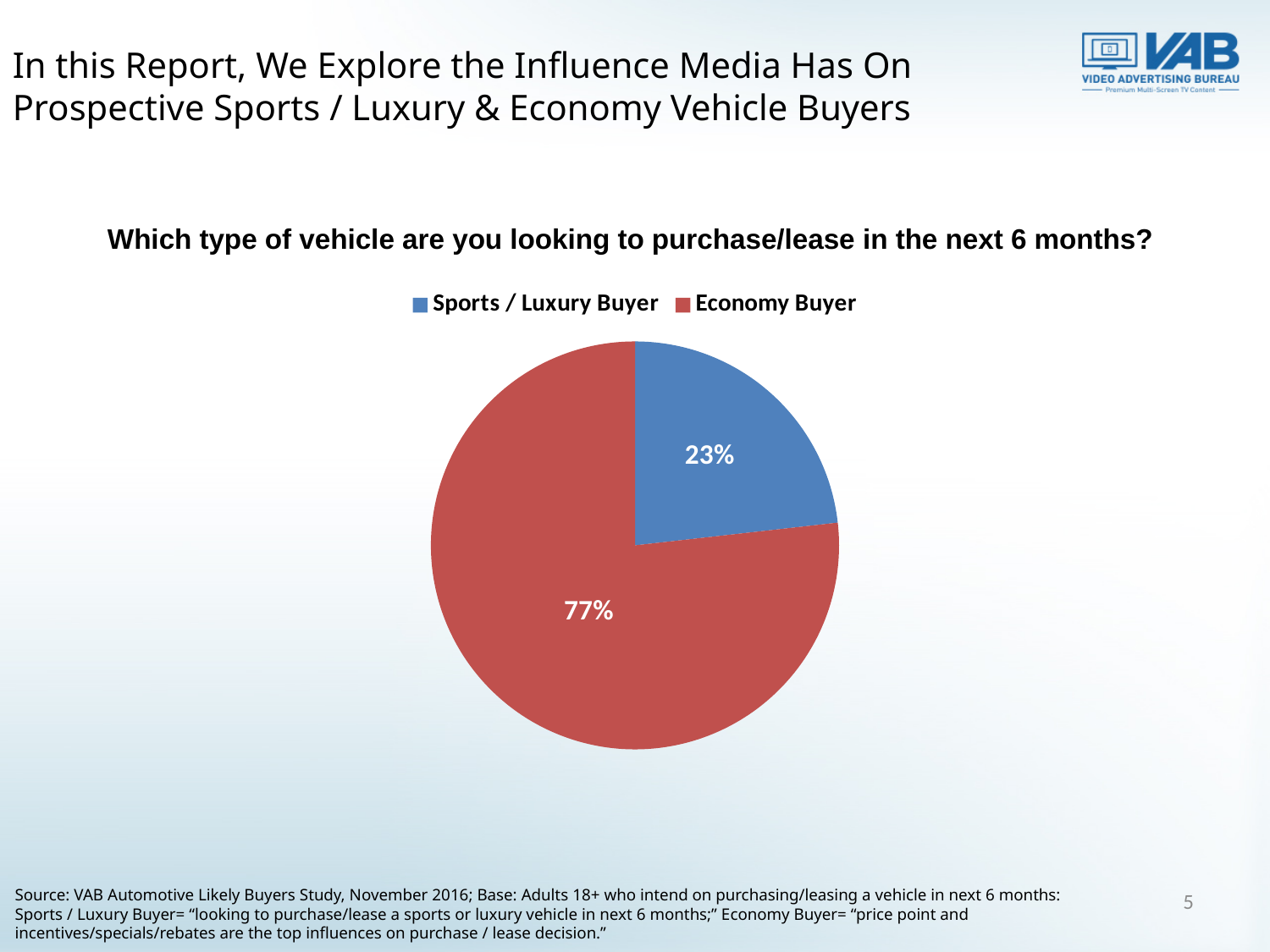
What kind of chart is shown on the slide? pie chart How many entries does the legend list? 2 What share of respondents are Sports / Luxury Buyers? 23% What colour is the Economy Buyer slice? red How many slices does the pie chart have? 2 What share of respondents are Economy Buyers? 77% What is the difference in percentage points between Economy Buyers and Sports / Luxury Buyers? 54 What is the total of the two slices shown in the pie chart? 100% What question is the pie chart answering, according to the heading above it? Which type of vehicle are you looking to purchase/lease in the next 6 months? Which buyer type has the smallest slice of the pie? Sports / Luxury Buyer Which is larger, the share of Economy Buyers or the share of Sports / Luxury Buyers? Economy Buyer Which buyer type has the largest slice of the pie? Economy Buyer